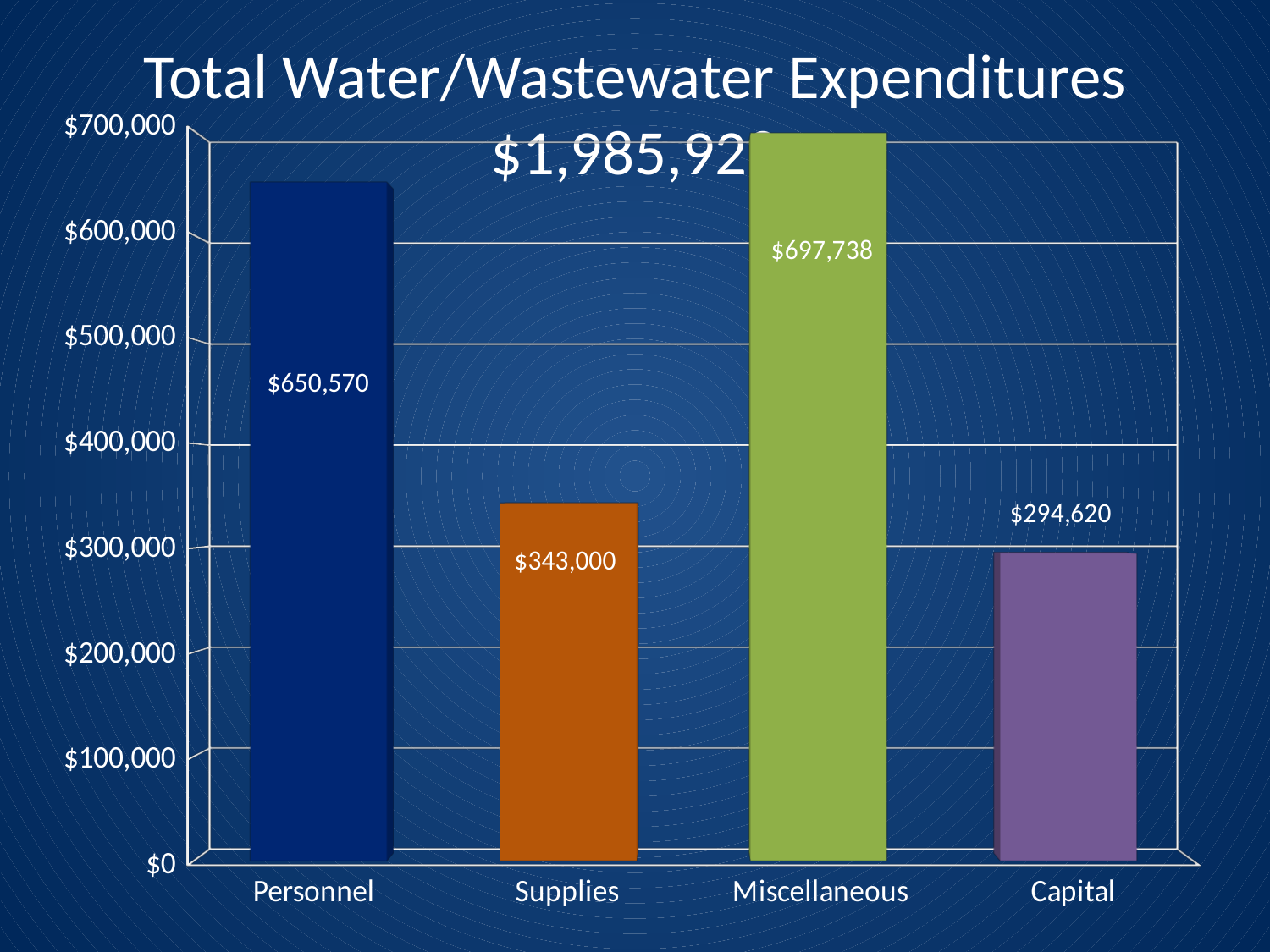
Which category has the lowest expenditure? Capital What is the difference between the Supplies and Capital values? $48,380 Which category has the highest expenditure? Miscellaneous What is the value for Capital? $294,620 Is the value for Supplies greater or less than $300,000? greater What kind of chart is shown on the slide? bar chart Which is larger, the value for Personnel or the value for Supplies? Personnel What is the value for Miscellaneous? $697,738 How many categories are shown on the chart? 4 What is the value for Supplies? $343,000 What is the difference between the Miscellaneous and Personnel values? $47,168 What is the value for Personnel? $650,570